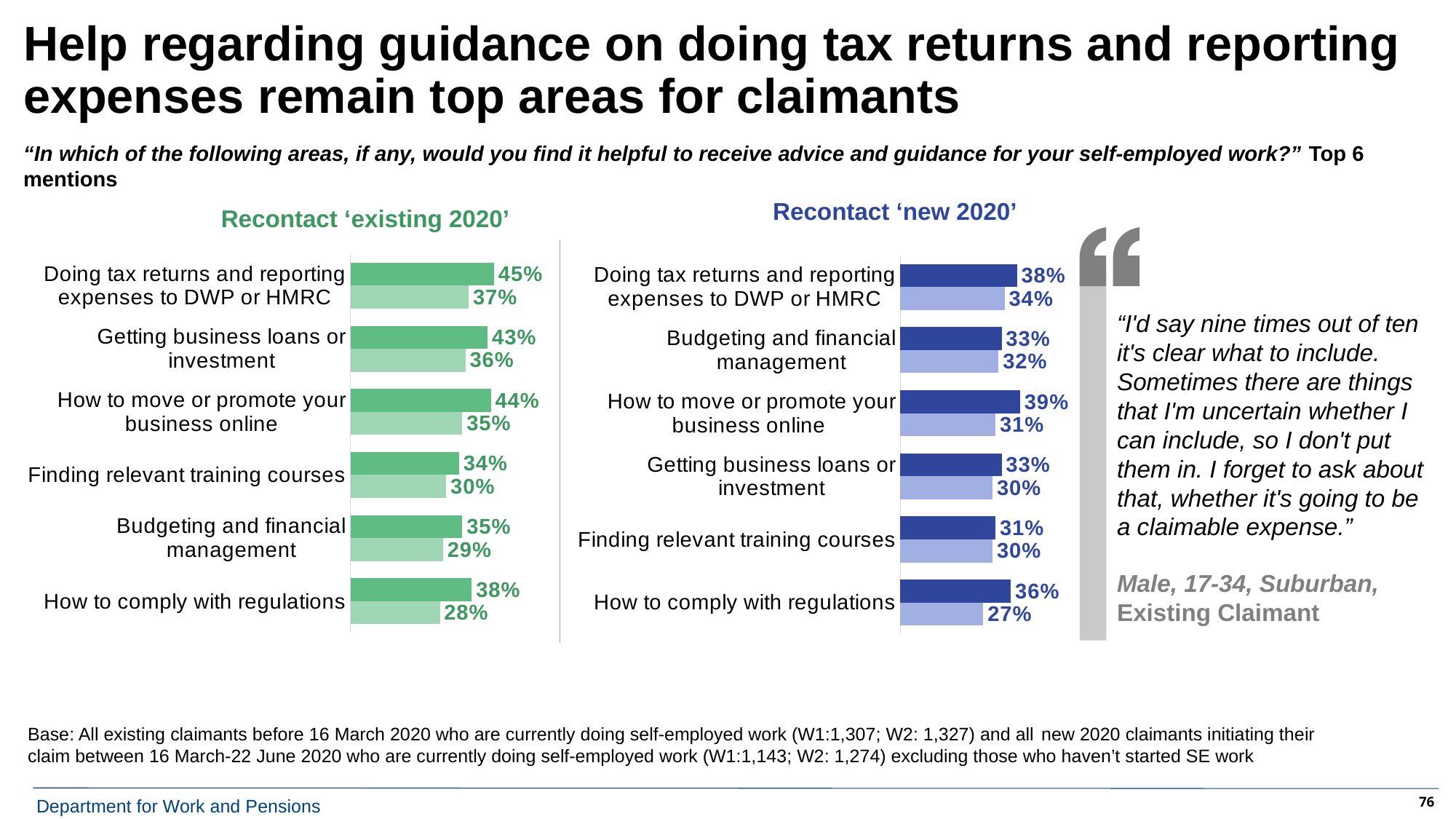
In the 'Recontact ‘existing 2020’' chart, what is the value of the lighter bar for 'Budgeting and financial management'? 29% What type of chart is the 'Recontact ‘existing 2020’' chart? Bar chart In the 'Recontact ‘new 2020’' chart, what is the difference between the darker and lighter bars for 'Doing tax returns and reporting expenses to DWP or HMRC'? 4 percentage points Which is larger: the darker bar for 'Getting business loans or investment' in the 'Recontact ‘existing 2020’' chart or the darker bar for the same category in the 'Recontact ‘new 2020’' chart? Recontact ‘existing 2020’ What colour are the bars in the 'Recontact ‘new 2020’' chart? Blue How many charts are shown on the slide? 2 In the 'Recontact ‘new 2020’' chart, which category has the highest darker-bar value? How to move or promote your business online How many categories are shown in the 'Recontact ‘new 2020’' chart? 6 In the 'Recontact ‘existing 2020’' chart, what is the value of the darker bar for 'Doing tax returns and reporting expenses to DWP or HMRC'? 45% In the 'Recontact ‘new 2020’' chart, what is the value of the lighter bar for 'How to comply with regulations'? 27% In the 'Recontact ‘existing 2020’' chart, what is the difference between the darker and lighter bars for 'How to comply with regulations'? 10 percentage points In the 'Recontact ‘existing 2020’' chart, which category has the lowest lighter-bar value? How to comply with regulations